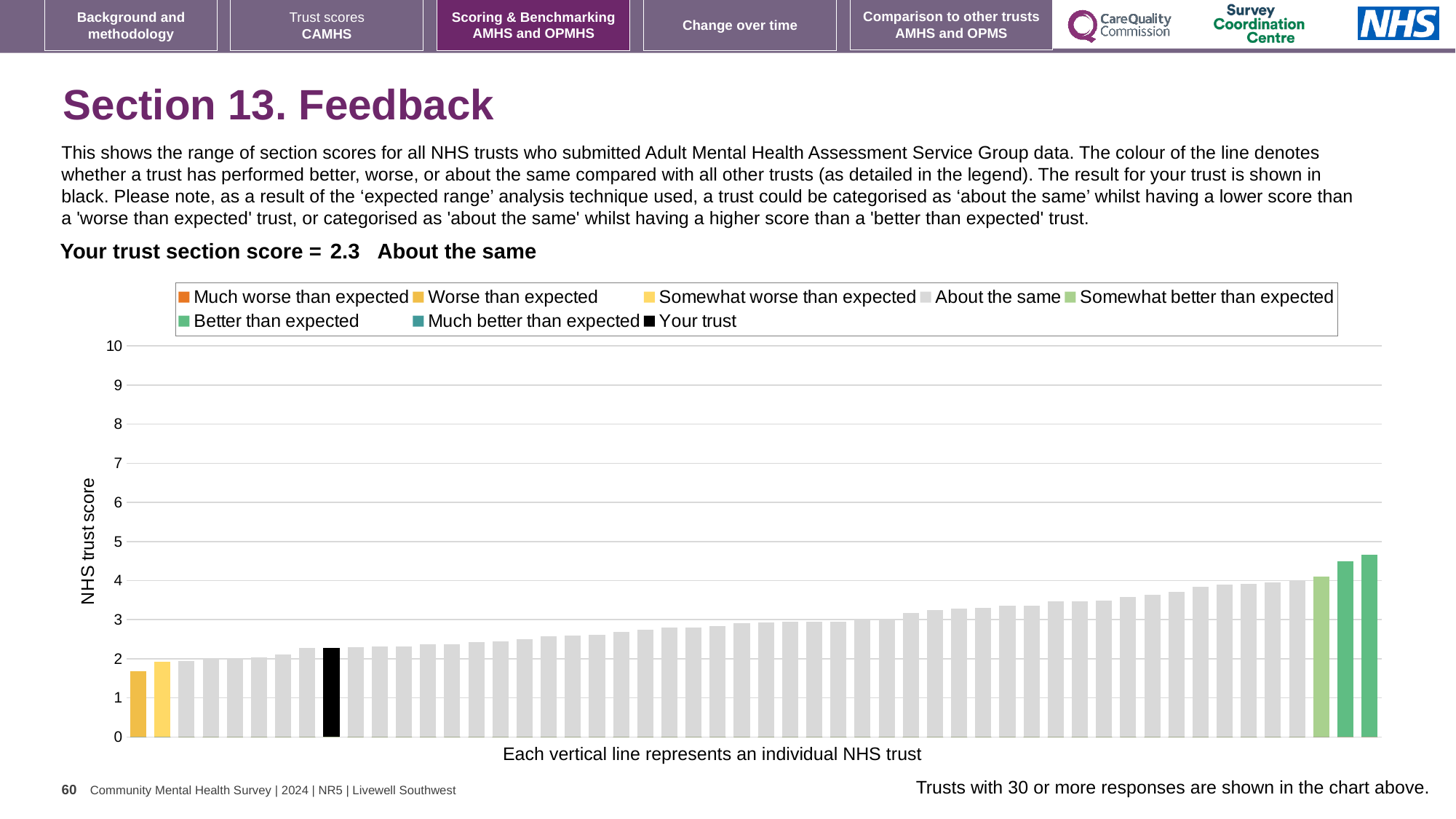
Which category is your trust's section score placed in? About the same Do the bar values rise or fall from left to right across the chart? rise How many entries does the chart legend list? 8 Is the value for the rightmost bar greater or less than 4? greater Is the value for the rightmost bar greater or less than 5? less Is the value for the leftmost bar greater or less than 2? less What kind of chart is shown on the slide? bar chart What is the title of the vertical axis? NHS trust score What is the section score for your trust shown on the slide? 2.3 Which is larger: the rightmost bar or the black bar for your trust? the rightmost bar